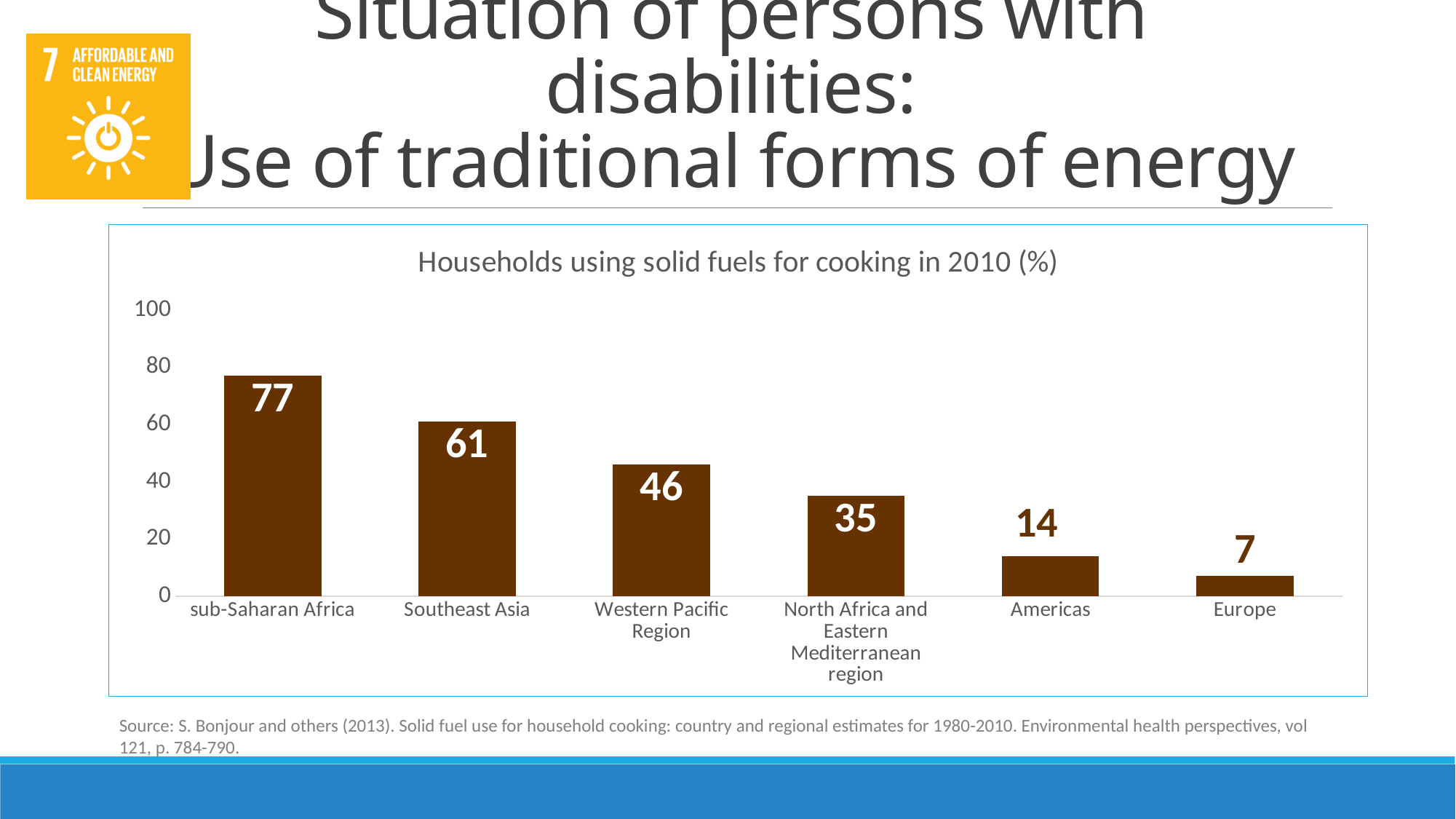
Which is larger, the value for North Africa and Eastern Mediterranean region or the value for the Americas? North Africa and Eastern Mediterranean region Do the values rise or fall from left to right across the regions? fall Is the value for Southeast Asia greater or less than 40? greater What is the difference between the values for Southeast Asia and the Americas? 47 Which region has the lowest percentage of households using solid fuels for cooking? Europe How many regions are shown in the chart? 6 What is the value for sub-Saharan Africa? 77 What is the value for Europe? 7 What kind of chart is shown on the slide? bar chart What is the title of the chart? Households using solid fuels for cooking in 2010 (%) What is the value for Western Pacific Region? 46 Which region has the highest percentage of households using solid fuels for cooking? sub-Saharan Africa